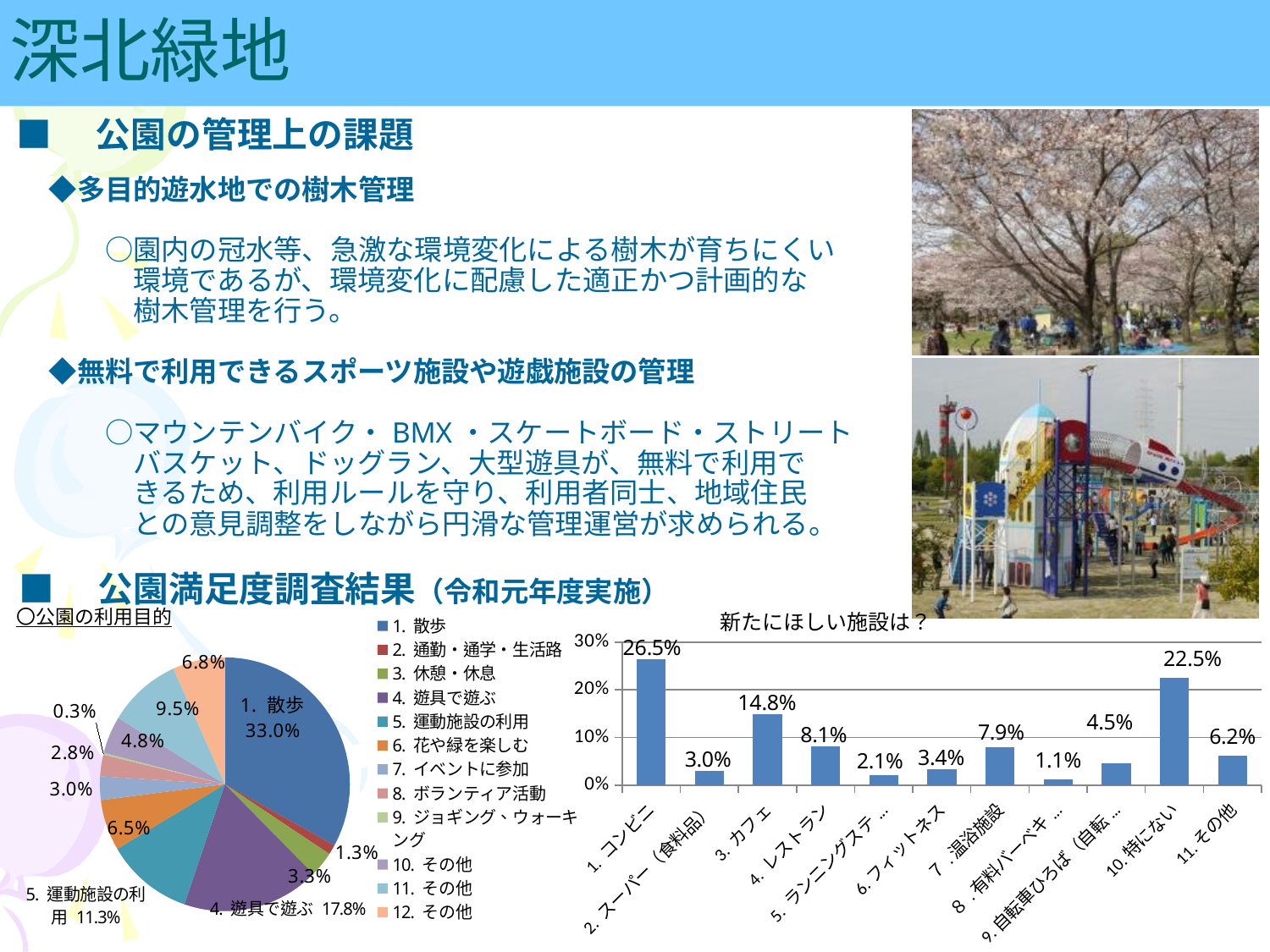
How many categories are shown in the bar chart titled 新たにほしい施設は？? 11 In the bar chart titled 新たにほしい施設は？, is the value for 3. カフェ greater or less than 10%? greater In the bar chart titled 新たにほしい施設は？, which category has the highest value? 1. コンビニ What kind of chart is the chart titled 新たにほしい施設は？? bar chart In the pie chart 公園の利用目的, which category has the largest slice? 1. 散歩 In the pie chart 公園の利用目的, what is the value for 4. 遊具で遊ぶ? 17.8% In the bar chart titled 新たにほしい施設は？, which is larger, the value for 3. カフェ or the value for 4. レストラン? 3. カフェ How many entries does the legend of the pie chart 公園の利用目的 list? 12 In the bar chart titled 新たにほしい施設は？, what is the value for 10. 特にない? 22.5% In the bar chart titled 新たにほしい施設は？, what is the value for 1. コンビニ? 26.5% In the bar chart titled 新たにほしい施設は？, what is the difference between the values for 1. コンビニ and 10. 特にない? 4.0% In the pie chart 公園の利用目的, what share does 1. 散歩 have? 33.0%